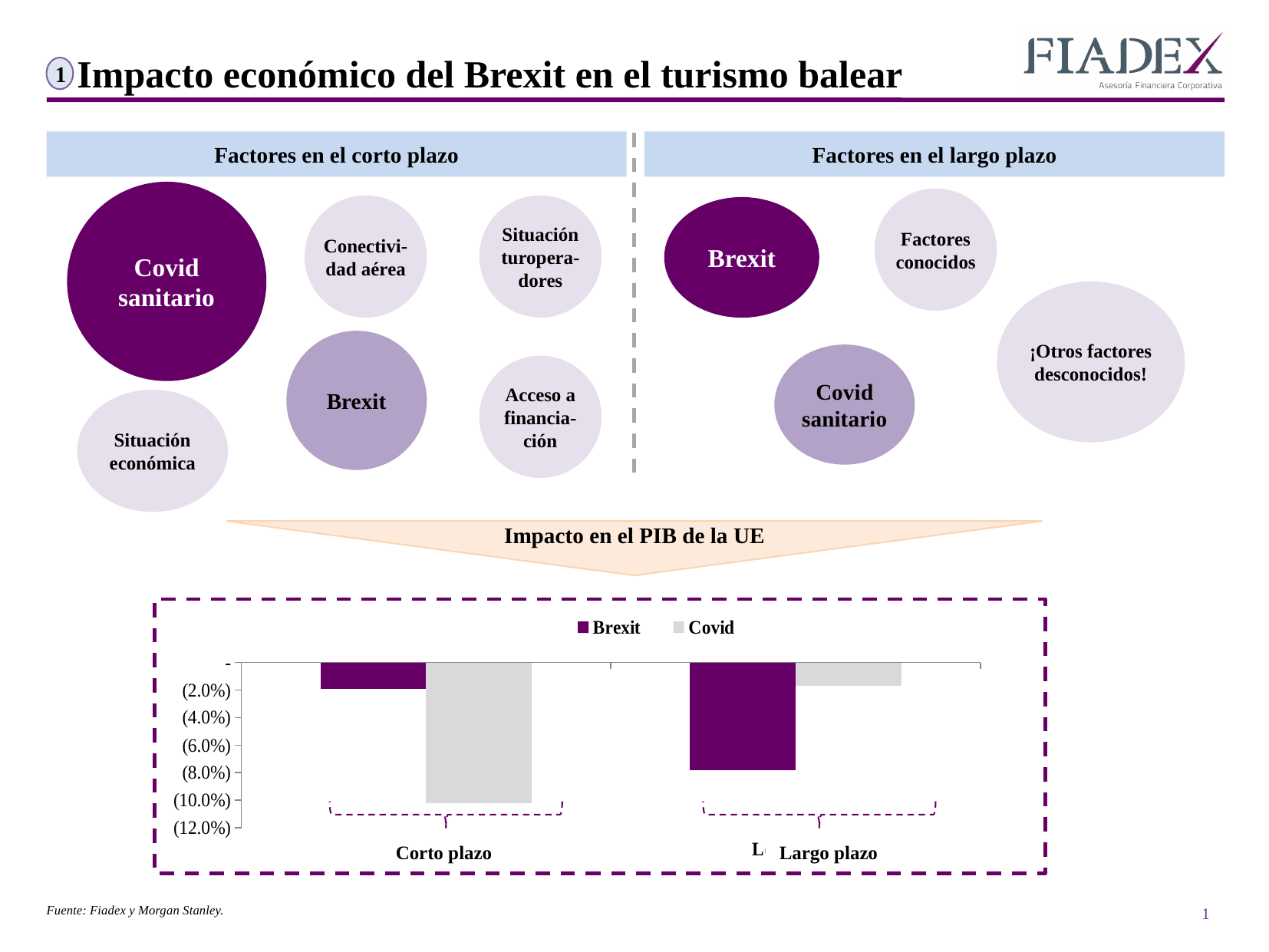
Is the magnitude of the Brexit impact for Largo plazo greater or less than 6.0%? greater What kind of chart is shown under 'Impacto en el PIB de la UE'? bar chart How many categories are shown on the x axis of the chart? 2 Does the negative impact of Brexit become larger or smaller from Corto plazo to Largo plazo? larger In the Largo plazo category, which series shows the larger negative impact on GDP, Brexit or Covid? Brexit In the Corto plazo category, which series shows the larger negative impact on GDP, Brexit or Covid? Covid Is the magnitude of the Covid impact for Corto plazo greater or less than 8.0%? greater Which series are listed in the chart's legend? Brexit and Covid What are the two categories on the x axis of the chart? Corto plazo and Largo plazo Is the magnitude of the Covid impact for Largo plazo greater or less than 4.0%? less How many series does the legend of the chart list? 2 Which bar in the chart shows the largest negative impact on GDP? Covid in Corto plazo